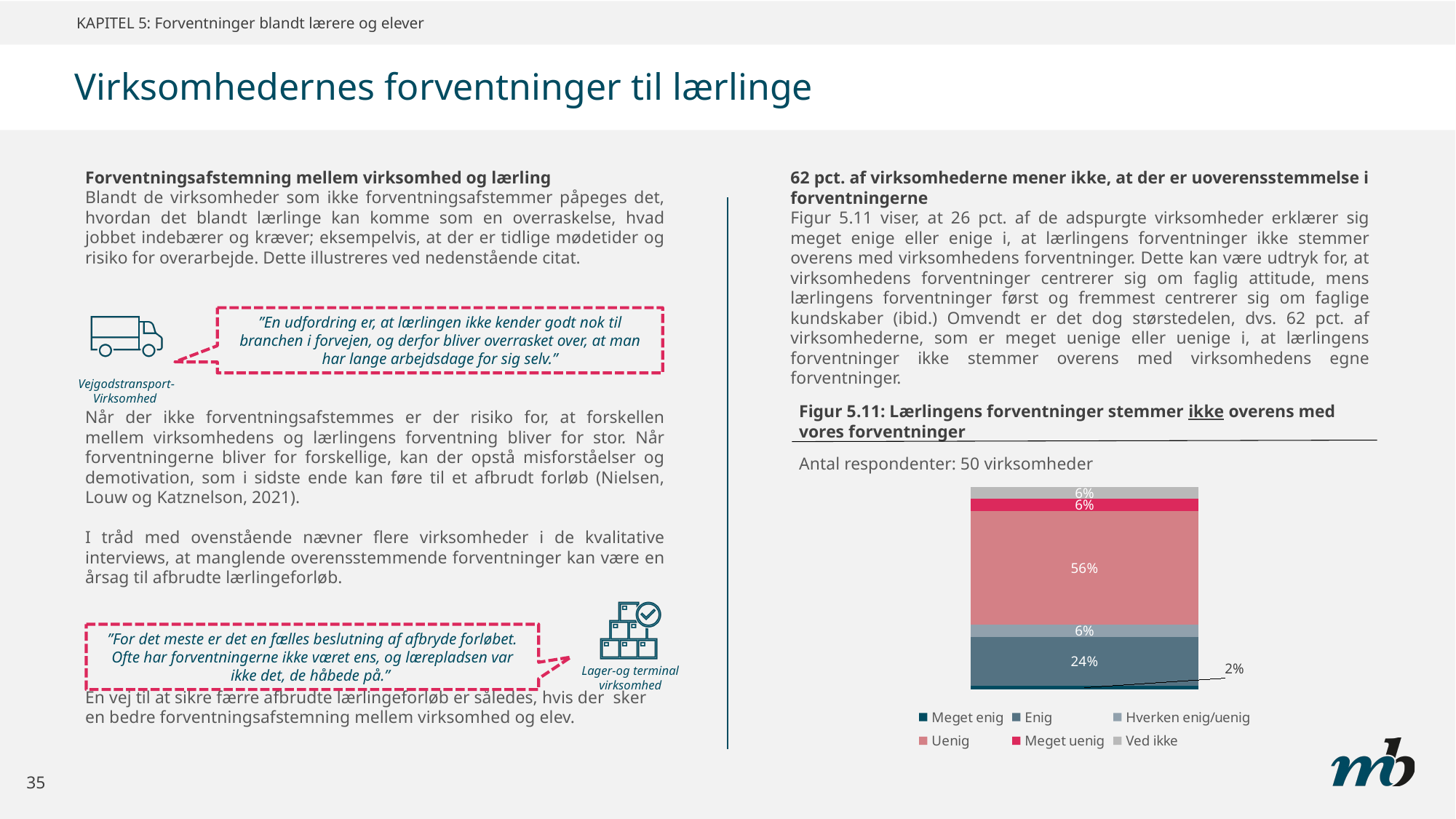
What share of respondents answered "Meget uenig" in Figur 5.11? 6% In Figur 5.11, which is larger: the share for "Enig" or the share for "Hverken enig/uenig"? Enig What share of respondents answered "Enig" in Figur 5.11? 24% What share of respondents answered "Uenig" in Figur 5.11? 56% Which response category has the largest share in Figur 5.11? Uenig Which response category has the smallest share in Figur 5.11? Meget enig In Figur 5.11, what is the difference between the share for "Uenig" and the share for "Enig"? 32% What share of respondents answered "Meget enig" in Figur 5.11? 2% In Figur 5.11, what is the combined share of "Enig" and "Meget enig"? 26% What kind of chart is Figur 5.11? Stacked bar chart How many respondents does Figur 5.11 state it is based on? 50 virksomheder How many series does the legend of Figur 5.11 list? 6